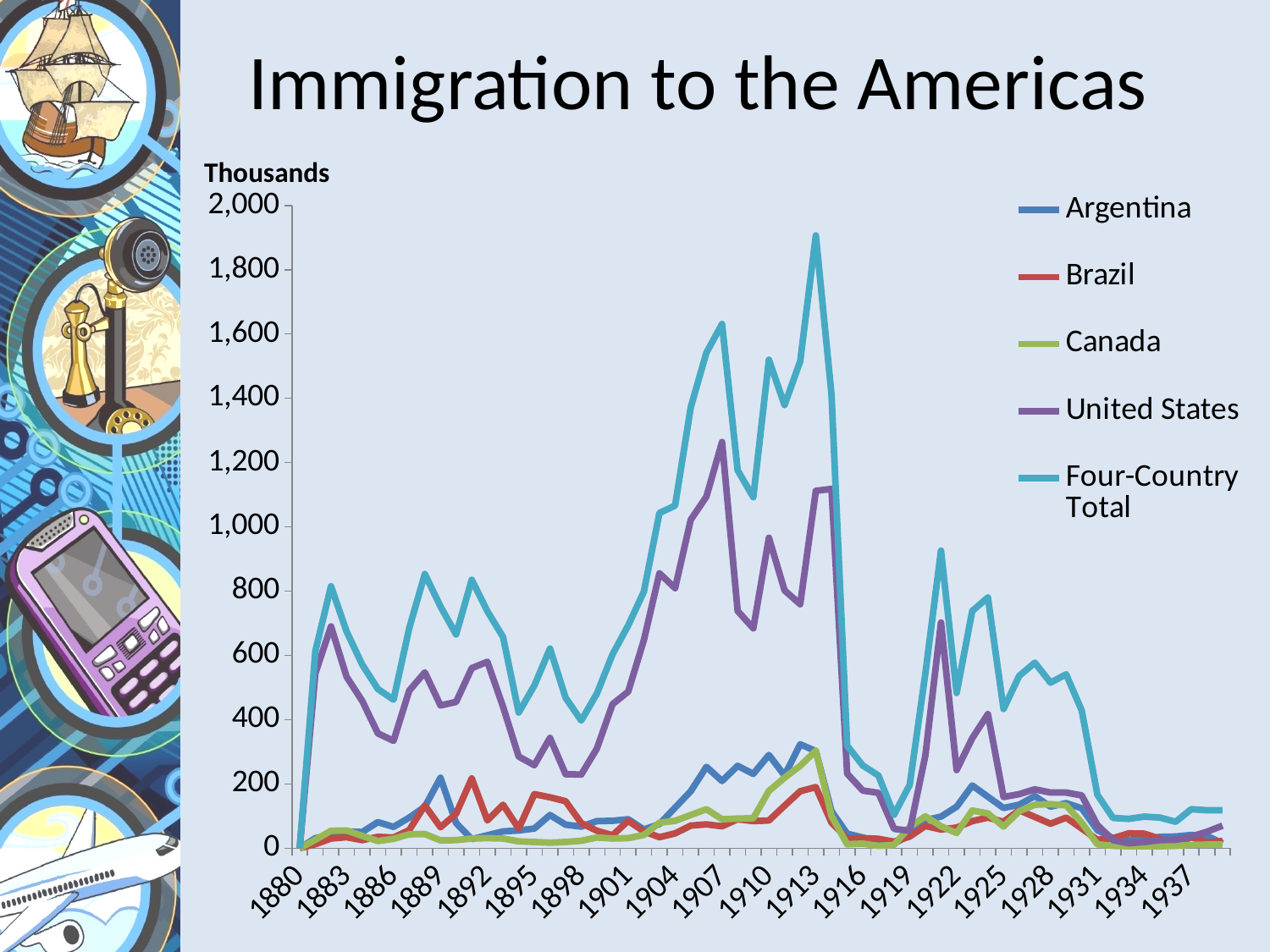
Is the Four-Country Total in 1913 greater or less than 1,800? greater Which series reaches the highest value on the chart? Four-Country Total Is the United States value in 1898 greater or less than 400? less In 1907, which is larger, Argentina or Brazil? Argentina How many series does the legend list? 5 Is the United States value in 1913 greater or less than 1,000? greater What is the title of the chart? Immigration to the Americas Between 1913 and 1916, does the Four-Country Total rise or fall? fall What kind of chart is shown on the slide? line chart What unit label is shown above the y axis? Thousands In which year does the Four-Country Total reach its peak? 1913